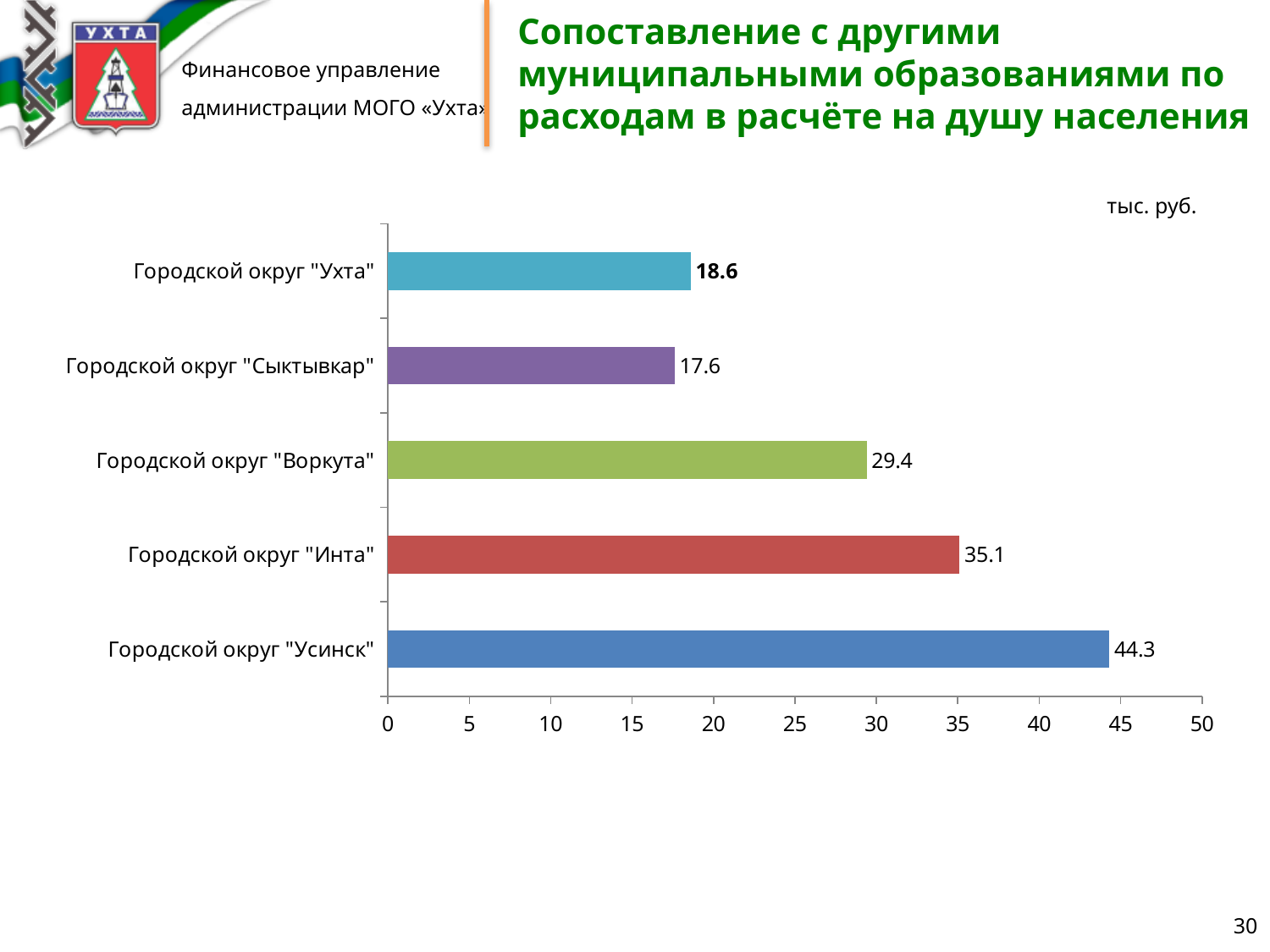
How many municipalities are shown in the chart? 5 What is the value for Городской округ "Ухта"? 18.6 What unit is indicated above the chart? тыс. руб. Is the value for Городской округ "Инта" greater or less than 30? greater What is the difference between the values for Городской округ "Усинск" and Городской округ "Инта"? 9.2 What is the value for Городской округ "Воркута"? 29.4 What is the value for Городской округ "Усинск"? 44.3 What kind of chart is shown on the slide? bar chart Which municipality has the lowest value? Городской округ "Сыктывкар" What is the difference between the values for Городской округ "Ухта" and Городской округ "Сыктывкар"? 1.0 Which is larger, the value for Городской округ "Воркута" or Городской округ "Инта"? Городской округ "Инта" Which municipality has the highest value? Городской округ "Усинск"